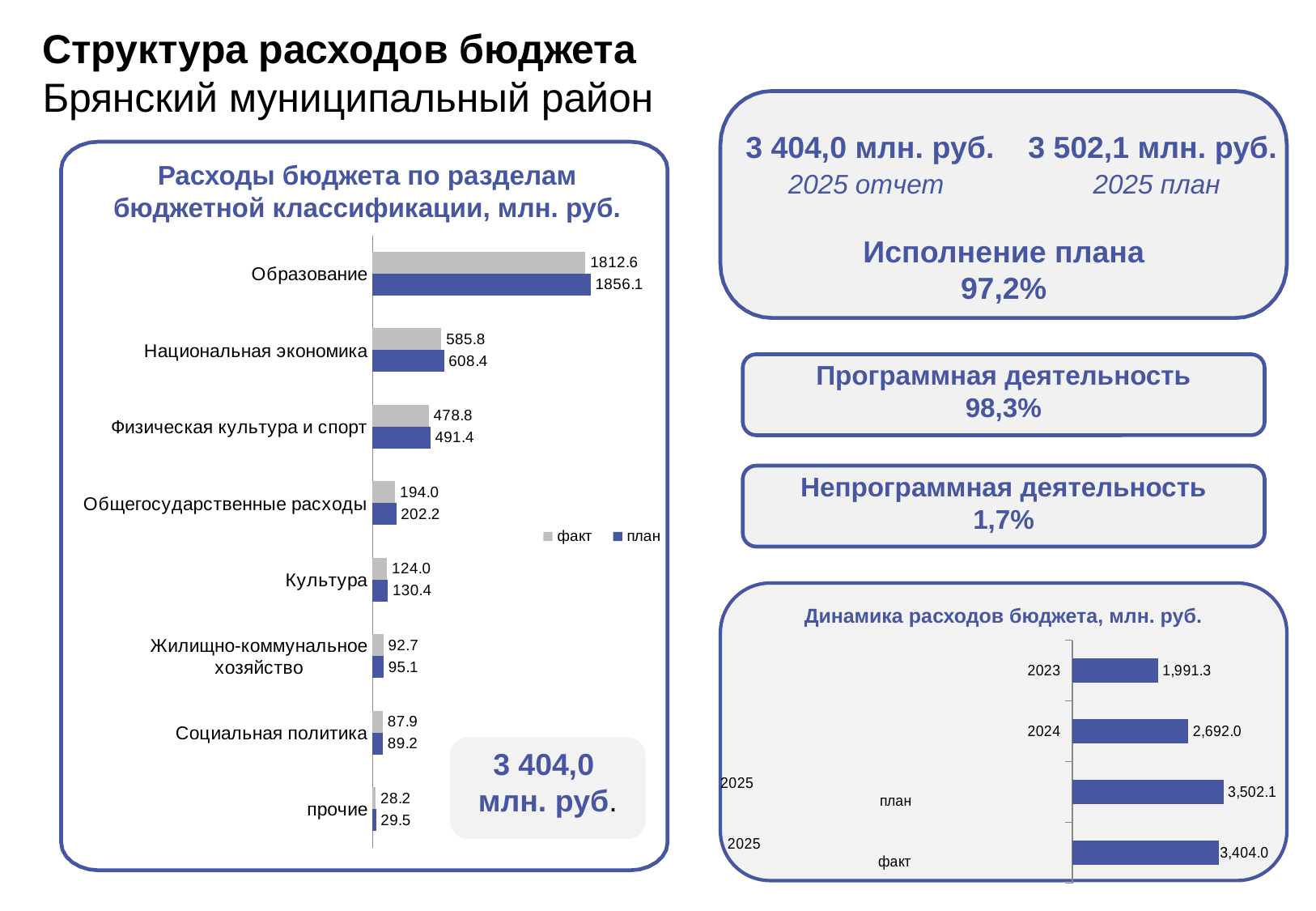
What kind of chart is 'Динамика расходов бюджета, млн. руб.'? bar chart In the chart 'Расходы бюджета по разделам бюджетной классификации, млн. руб.', what is the план value for Национальная экономика? 608.4 In the chart 'Динамика расходов бюджета, млн. руб.', what is the difference between the 2025 план and 2025 факт values? 98.1 How many categories are shown in the chart 'Расходы бюджета по разделам бюджетной классификации, млн. руб.'? 8 In the chart 'Динамика расходов бюджета, млн. руб.', what is the value for 2024? 2,692.0 In the chart 'Расходы бюджета по разделам бюджетной классификации, млн. руб.', what is the факт value for Образование? 1812.6 How many series does the legend list in the chart 'Расходы бюджета по разделам бюджетной классификации, млн. руб.'? 2 In the chart 'Динамика расходов бюджета, млн. руб.', which bar has the lowest value? 2023 In the chart 'Расходы бюджета по разделам бюджетной классификации, млн. руб.', which is larger for Культура: факт or план? план In the chart 'Расходы бюджета по разделам бюджетной классификации, млн. руб.', which category has the highest факт value? Образование In the chart 'Расходы бюджета по разделам бюджетной классификации, млн. руб.', which category has the lowest план value? прочие In the chart 'Расходы бюджета по разделам бюджетной классификации, млн. руб.', what is the difference between the план and факт values for Образование? 43.5